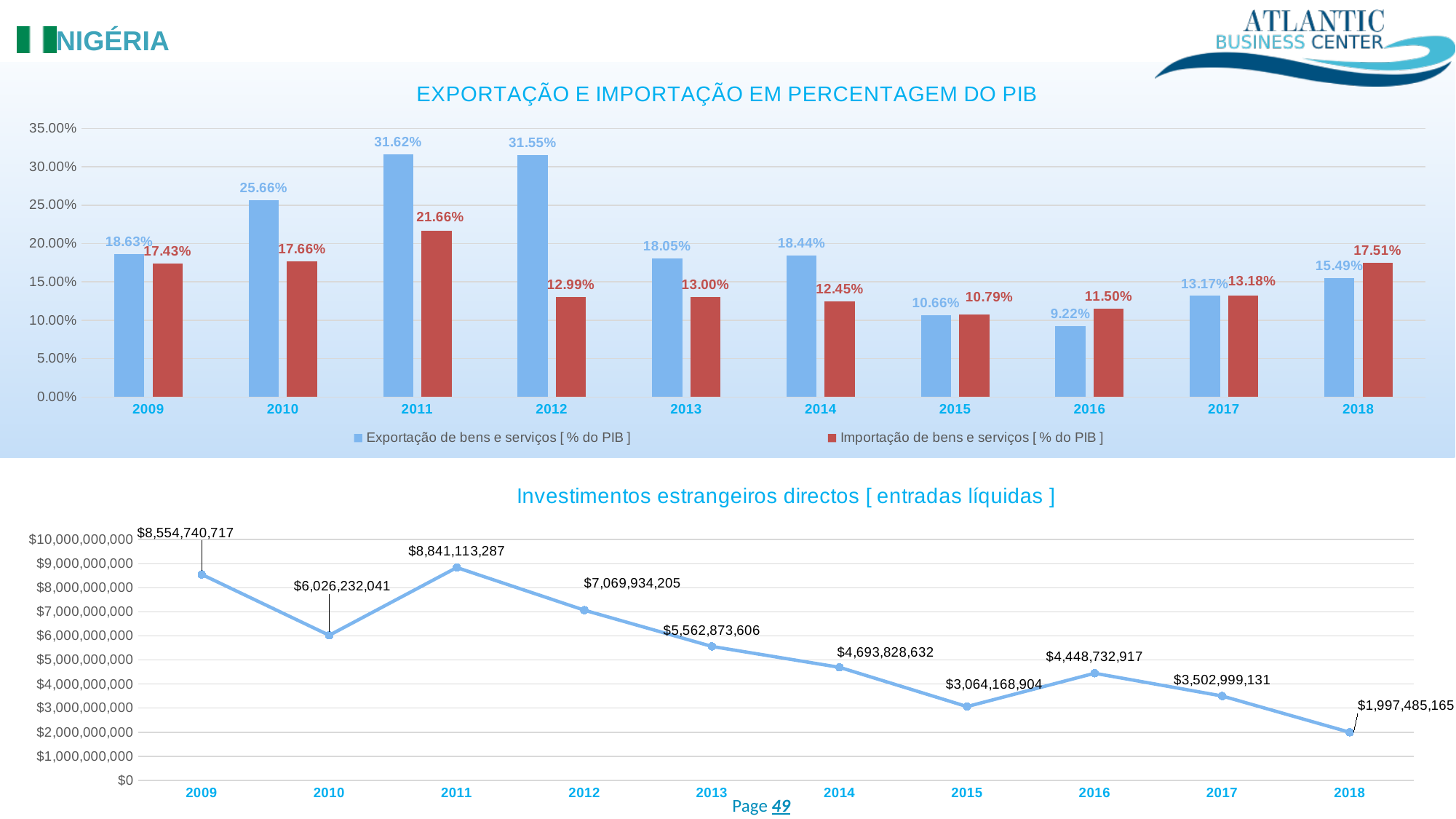
In the chart titled 'EXPORTAÇÃO E IMPORTAÇÃO EM PERCENTAGEM DO PIB', which is larger in 2018: Exportação or Importação? Importação In the chart titled 'Investimentos estrangeiros directos [ entradas líquidas ]', which year has the highest value? 2011 What kind of chart is the chart titled 'Investimentos estrangeiros directos [ entradas líquidas ]'? Line chart In the chart titled 'EXPORTAÇÃO E IMPORTAÇÃO EM PERCENTAGEM DO PIB', what is the difference between the Exportação and Importação values for 2011? 9.96% In the chart titled 'EXPORTAÇÃO E IMPORTAÇÃO EM PERCENTAGEM DO PIB', what is the value of Importação de bens e serviços for 2014? 12.45% How many years are plotted in the chart titled 'Investimentos estrangeiros directos [ entradas líquidas ]'? 10 How many series does the legend of the chart titled 'EXPORTAÇÃO E IMPORTAÇÃO EM PERCENTAGEM DO PIB' list? 2 In the chart titled 'EXPORTAÇÃO E IMPORTAÇÃO EM PERCENTAGEM DO PIB', what is the value of Exportação de bens e serviços for 2011? 31.62% In the chart titled 'Investimentos estrangeiros directos [ entradas líquidas ]', what is the value for 2015? $3,064,168,904 In the chart titled 'Investimentos estrangeiros directos [ entradas líquidas ]', what is the difference between the 2011 and 2018 values? $6,843,628,122 In the chart titled 'EXPORTAÇÃO E IMPORTAÇÃO EM PERCENTAGEM DO PIB', which year has the lowest Exportação de bens e serviços value? 2016 In the chart titled 'EXPORTAÇÃO E IMPORTAÇÃO EM PERCENTAGEM DO PIB', which year has the highest Importação de bens e serviços value? 2011